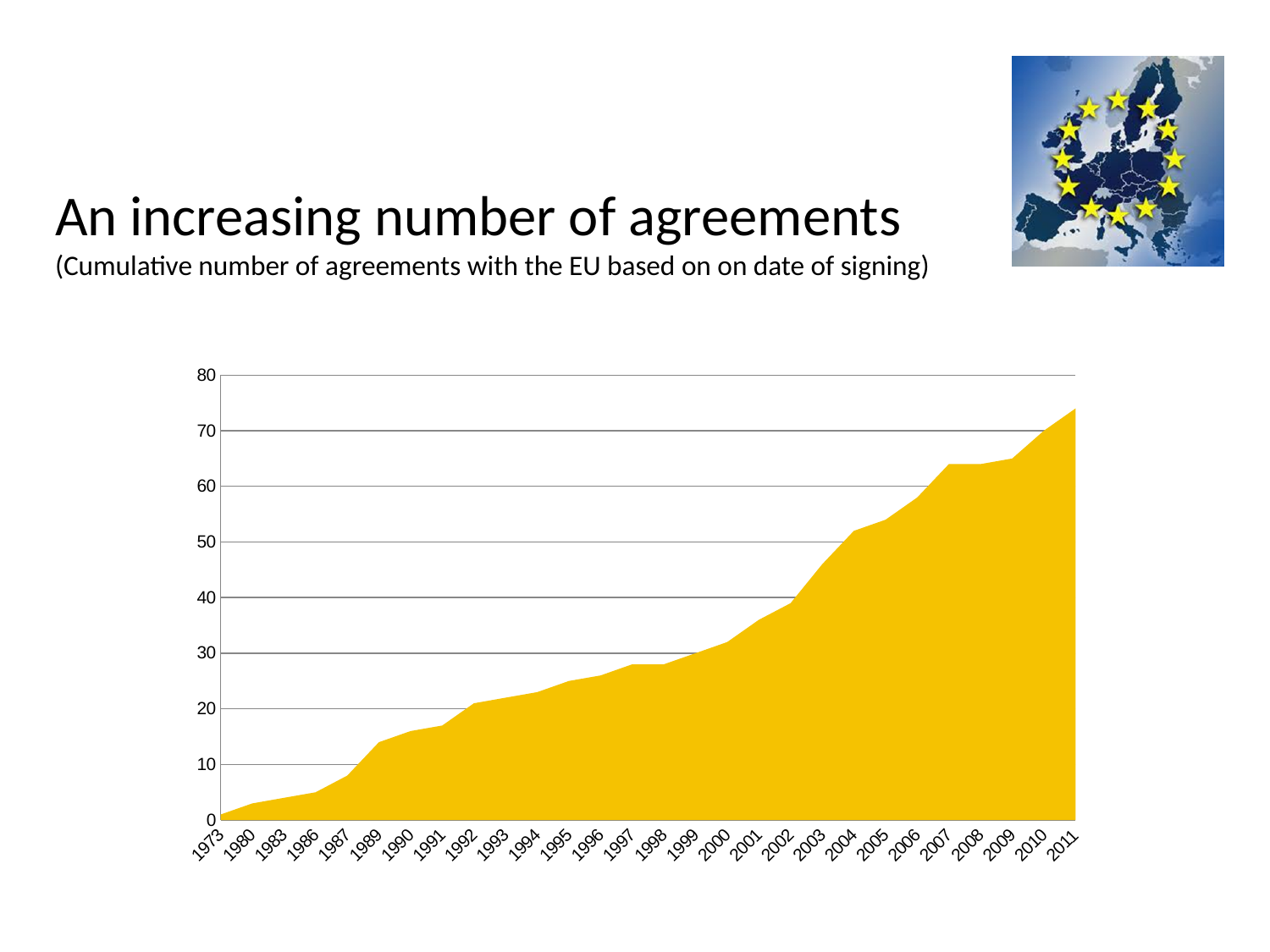
Which year has the lowest cumulative number of agreements? 1973 Which is larger, the value for 2004 or the value for 1994? 2004 How many years are plotted on the x axis? 28 What is the title of the slide above the chart? An increasing number of agreements Do the values rise or fall along the x axis from 1973 to 2011? rise Is the value for 1997 greater or less than 30? less What kind of chart is shown on the slide? area chart Which year has the highest cumulative number of agreements? 2011 Is the value for 2011 greater or less than 70? greater Is the value for 1980 greater or less than 10? less